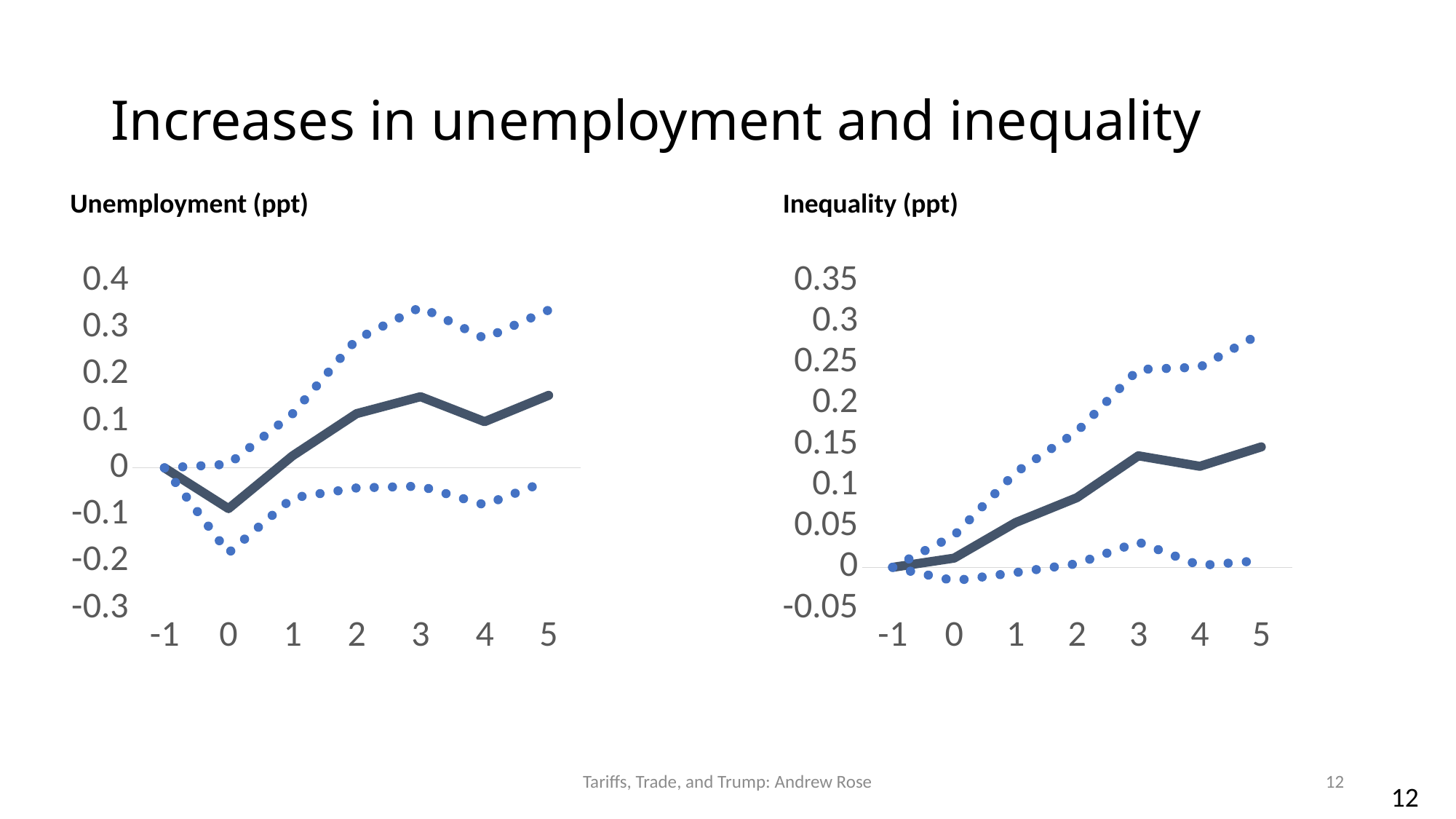
On the Unemployment (ppt) chart, is the solid line's value larger at x = 2 or at x = 0? x = 2 On the Unemployment (ppt) chart, is the solid line's value at x = 3 greater or less than 0.1? greater On the Unemployment (ppt) chart, is the solid line's value at x = 0 greater or less than 0? less On the Inequality (ppt) chart, is the upper dotted line's value at x = 5 greater or less than 0.25? greater How many x-axis points are plotted on the Inequality (ppt) chart? 7 What kind of chart is the Unemployment (ppt) chart? line chart On the Unemployment (ppt) chart, what is the value of the solid line at x = -1? 0 On the Inequality (ppt) chart, does the solid line generally rise or fall from x = -1 to x = 5? rise On the Unemployment (ppt) chart, at which x value is the solid line lowest? 0 On the Inequality (ppt) chart, what is the value of the solid line at x = -1? 0